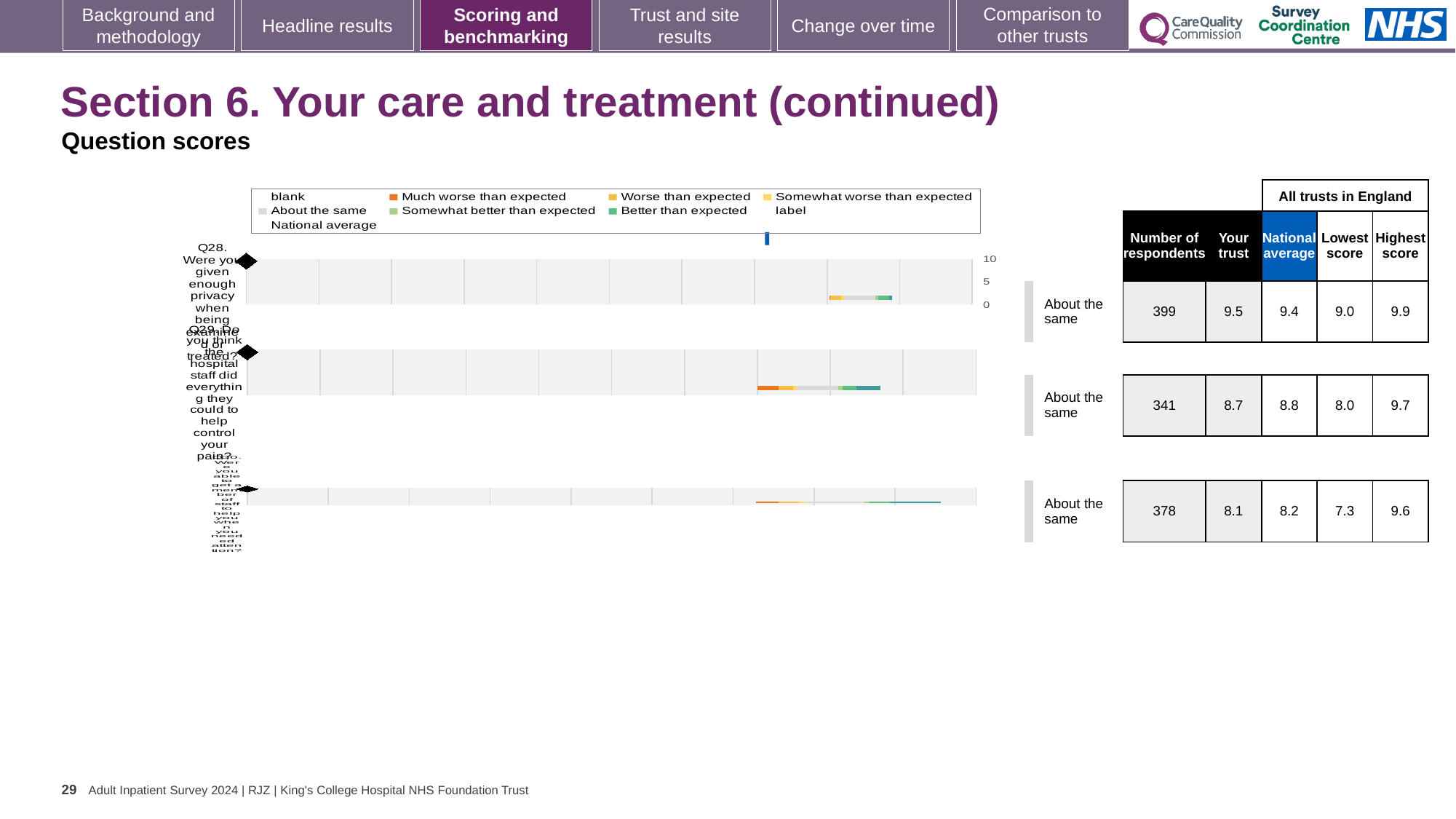
What benchmark category is shown for Q28? About the same What is the difference between the highest score (9.9) and the lowest score (9.0) across all trusts in England for Q28? 0.9 What is the 'Your trust' score for Q28 (privacy when being examined or treated)? 9.5 How many respondents answered Q30? 378 What kind of chart is used to show the question scores on this slide? bar chart Which question has the highest 'Your trust' score? Q28 For Q29, which is larger: the 'Your trust' score or the national average? National average What is the highest tick value shown on the score axis of the chart? 10 What is the national average score for Q29 (hospital staff helping control pain)? 8.8 How many questions (rows) are plotted in the question scores chart? 3 Which question has the lowest 'Your trust' score? Q30 What colour does the legend use for 'Much worse than expected'? Orange